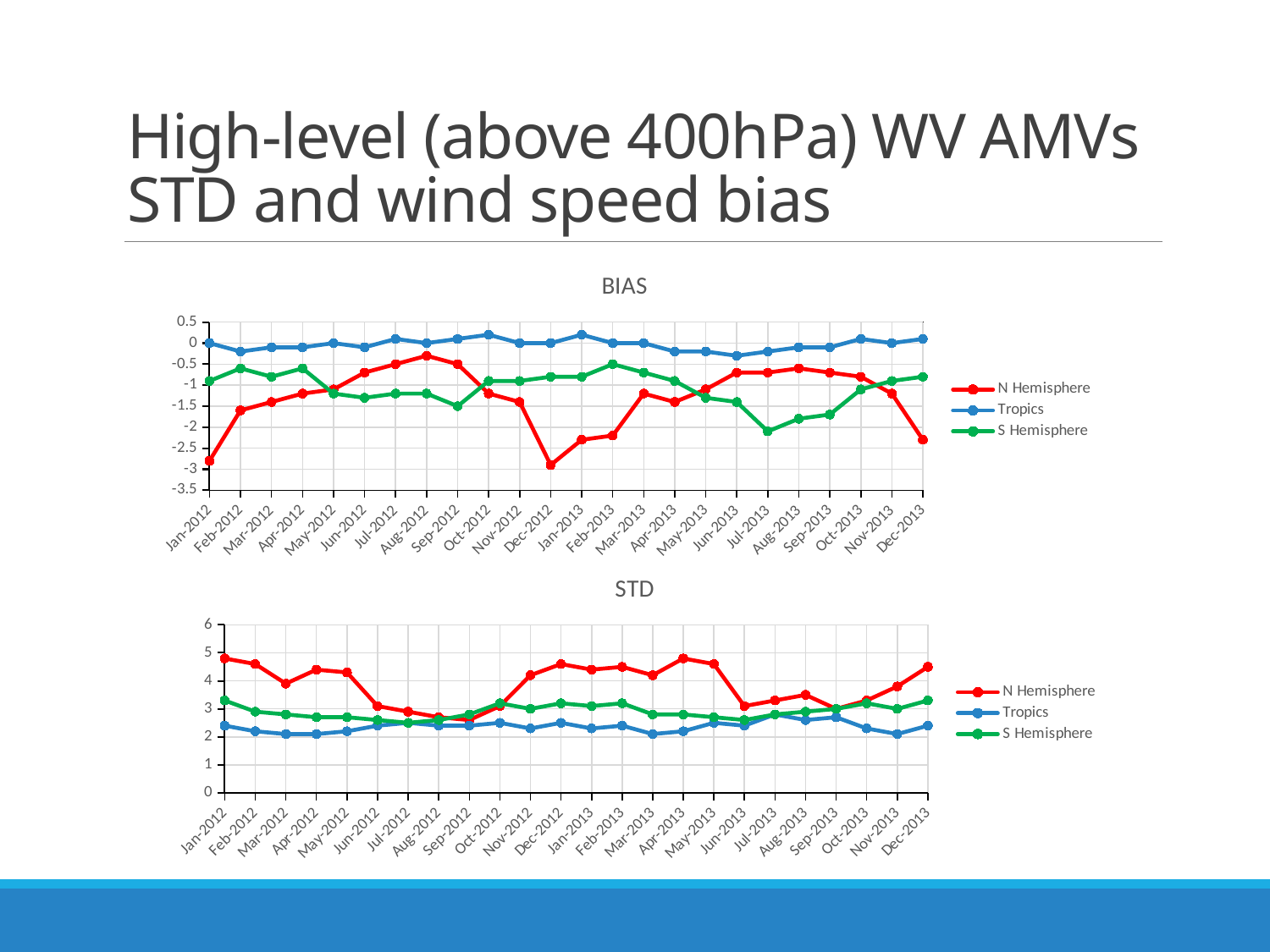
How many monthly points are plotted along the x axis of the BIAS chart? 24 What kind of chart is the BIAS chart? line chart In the BIAS chart, which is larger in Jan-2012, the N Hemisphere value or the S Hemisphere value? S Hemisphere In the STD chart, is the value for Tropics in Mar-2012 greater or less than 3? less In the BIAS chart, is the value for Tropics in Oct-2012 greater or less than 0? greater In the STD chart, does the N Hemisphere line rise or fall from Jan-2012 to Mar-2012? fall How many series does the legend of the STD chart list? 3 In the BIAS chart, is the value for S Hemisphere in Jul-2013 greater or less than -1.5? less What is the title of the lower chart on the slide? STD In the STD chart, which is larger in Jan-2012, the N Hemisphere value or the Tropics value? N Hemisphere